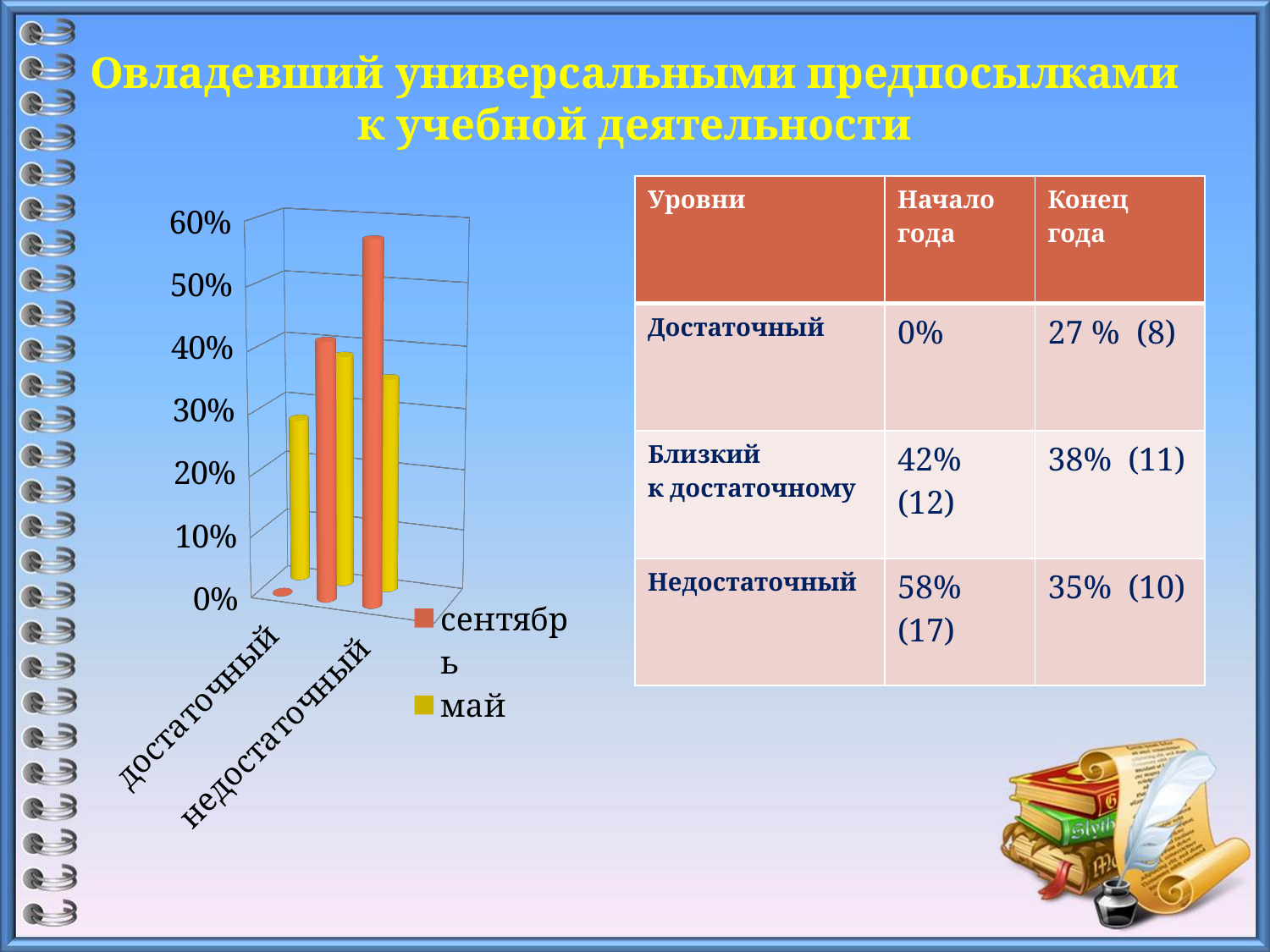
What are the two series named in the chart legend? сентябрь and май How many groups of bars are plotted in the chart? 3 Is the май value for недостаточный greater or less than 50%? less What kind of chart is shown on the slide? bar chart For недостаточный, which series has the taller bar, сентябрь or май? сентябрь Is the май value for достаточный greater or less than 20%? greater What colour are the bars for the series май? yellow How many series does the chart legend list? 2 Is the сентябрь value for недостаточный greater or less than 50%? greater Which labelled category has the tallest сентябрь bar? недостаточный For достаточный, which series has the taller bar, сентябрь or май? май